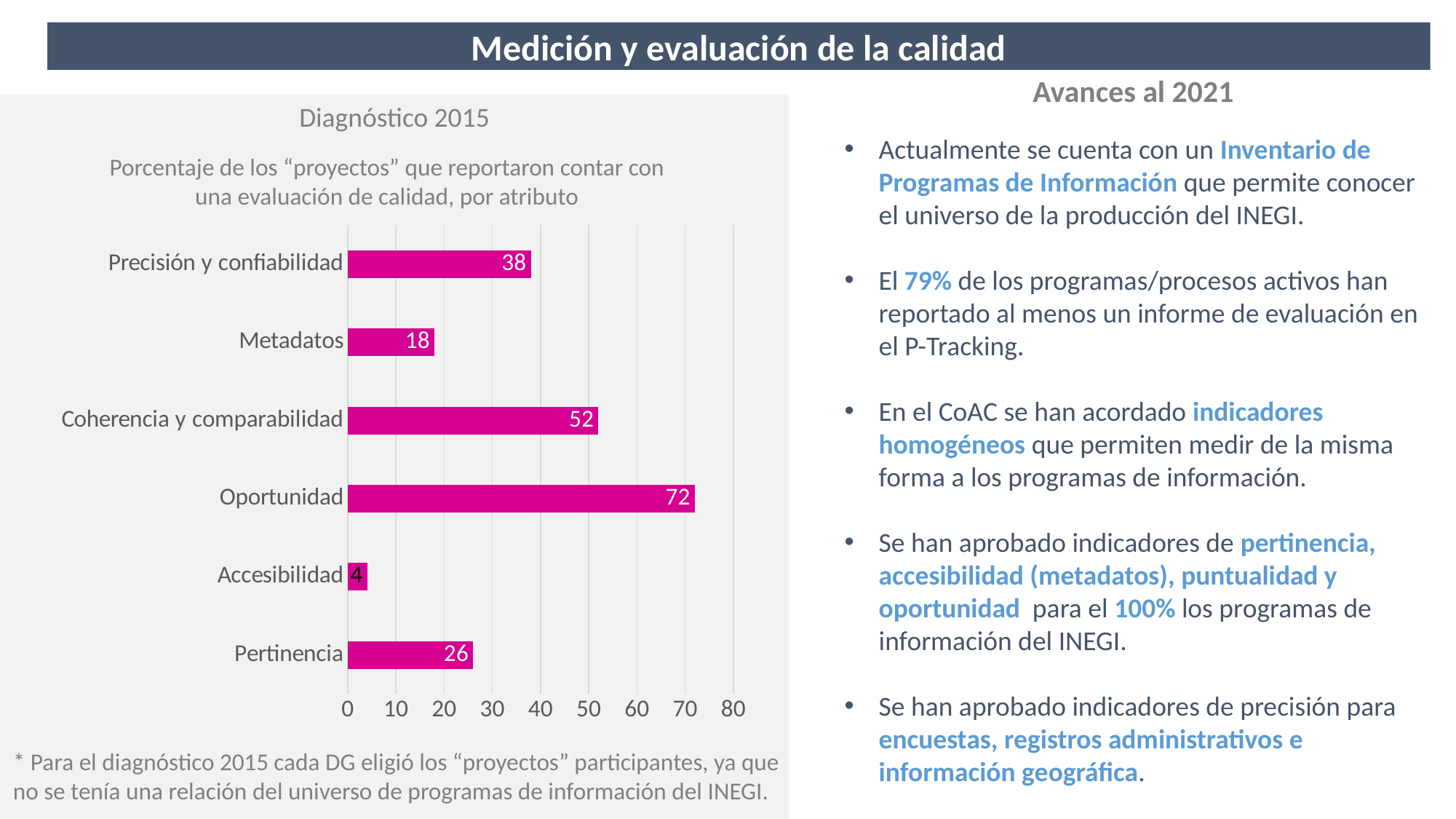
How many attributes are shown in the chart? 6 Is the value for Coherencia y comparabilidad greater or less than 50? greater What is the difference between the values for Oportunidad and Coherencia y comparabilidad? 20 What is the title of the chart? Diagnóstico 2015 What kind of chart is shown on the slide? bar chart Which attribute has the highest value? Oportunidad What is the value for Pertinencia? 26 What is the difference between the values for Precisión y confiabilidad and Metadatos? 20 Which is larger, the value for Pertinencia or the value for Metadatos? Pertinencia What is the value for Metadatos? 18 What is the value for Oportunidad? 72 Which attribute has the lowest value? Accesibilidad